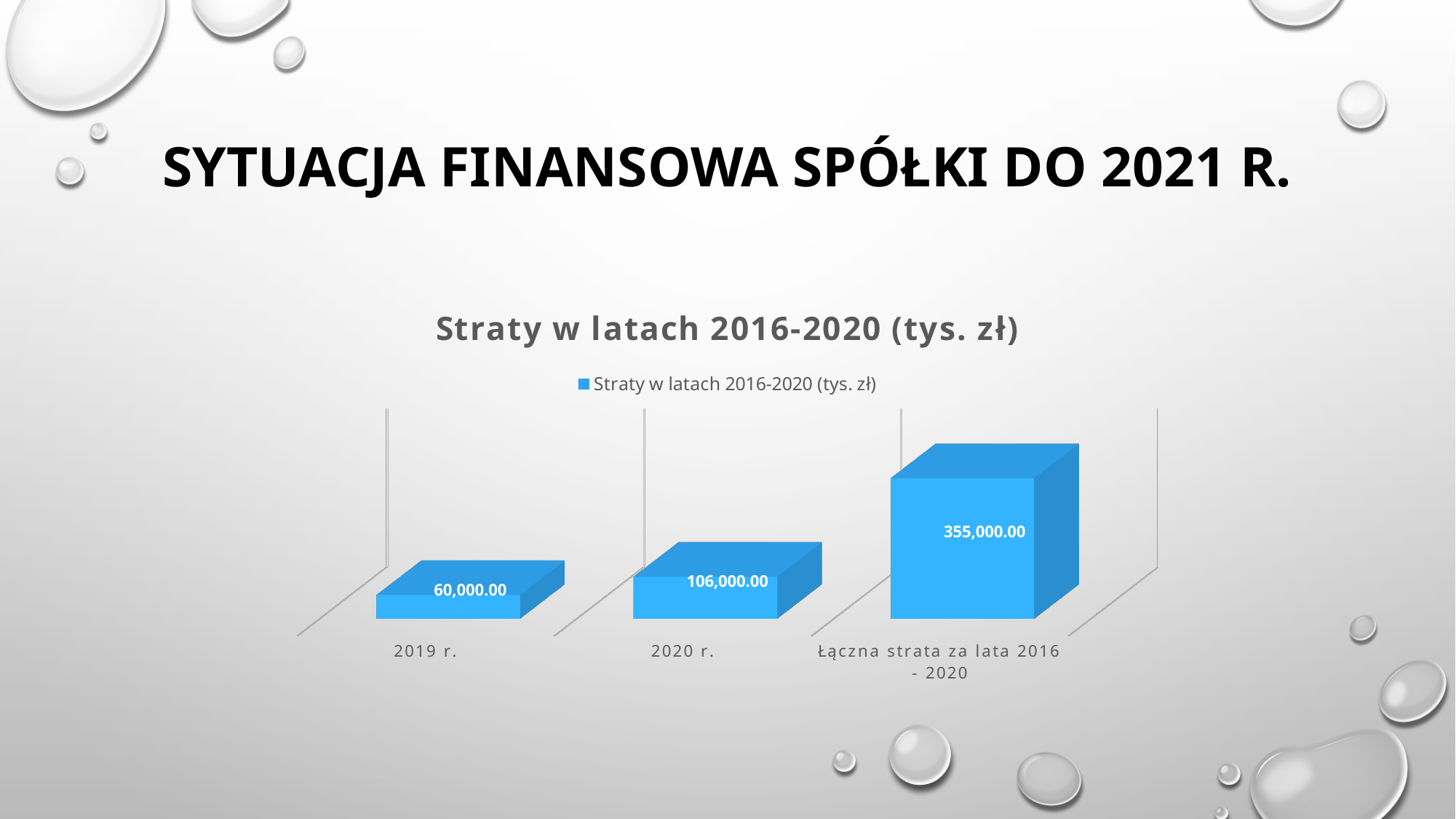
Which category has the highest value? Łączna strata za lata 2016 - 2020 What is the title of the chart? Straty w latach 2016-2020 (tys. zł) What is the difference between the values for 2020 r. and 2019 r.? 46,000.00 What kind of chart is shown on the slide? bar chart Which category has the lowest value? 2019 r. What is the value for Łączna strata za lata 2016 - 2020? 355,000.00 How many categories are shown in the chart? 3 What is the value for 2020 r.? 106,000.00 What is the difference between the values for Łączna strata za lata 2016 - 2020 and 2020 r.? 249,000.00 How many series does the legend list? 1 What is the value for 2019 r.? 60,000.00 Which is larger, the value for 2019 r. or the value for 2020 r.? 2020 r.